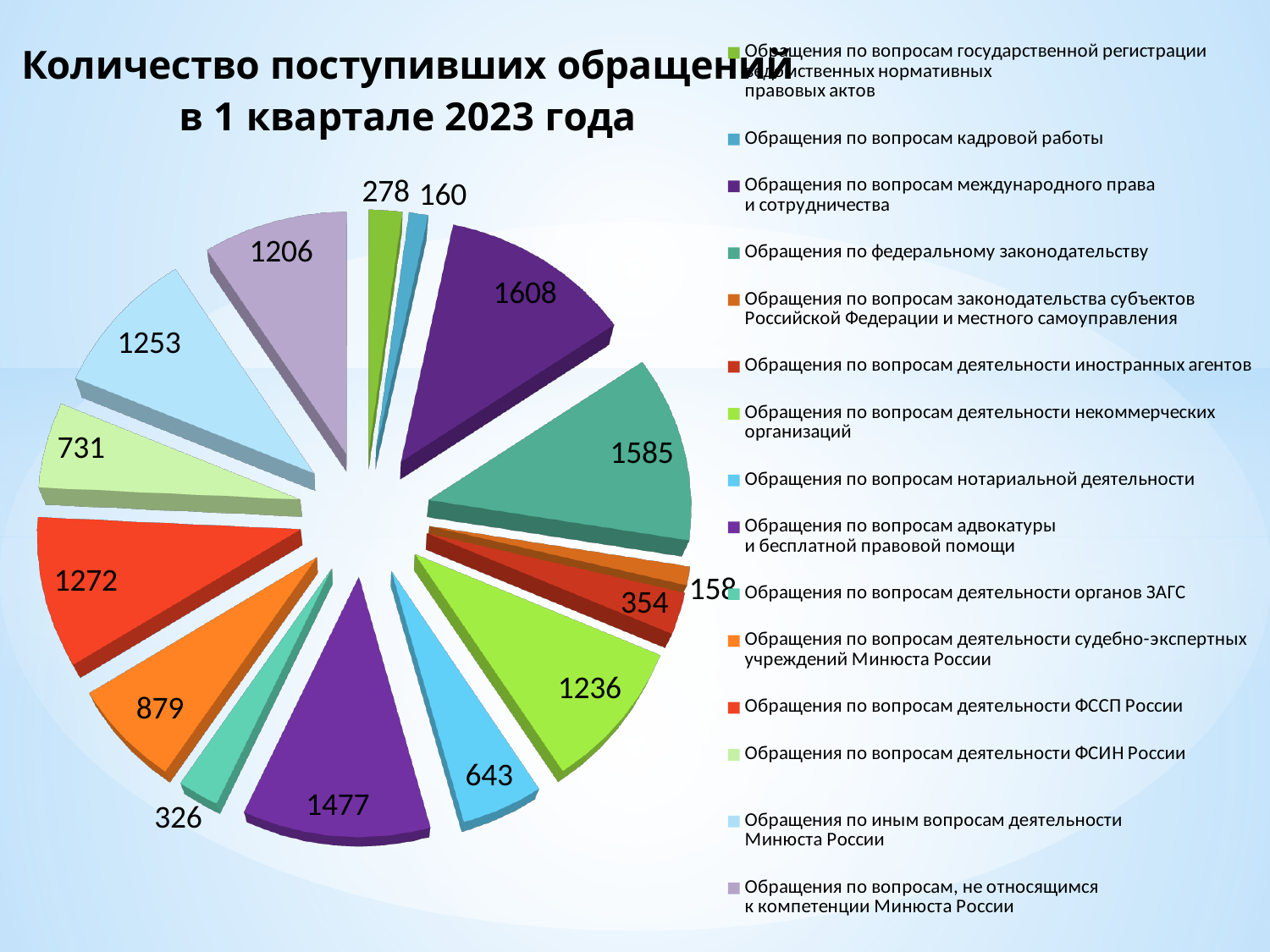
What type of chart is shown on the slide? pie chart How many entries does the legend list? 15 What is the value for 'Обращения по вопросам нотариальной деятельности'? 643 What is the difference between the values for 'Обращения по вопросам адвокатуры и бесплатной правовой помощи' and 'Обращения по вопросам деятельности ФСИН России'? 746 How many slices does the pie chart have? 15 What is the value for 'Обращения по вопросам международного права и сотрудничества'? 1608 What is the value for 'Обращения по вопросам деятельности органов ЗАГС'? 326 What is the title of the chart? Количество поступивших обращений в 1 квартале 2023 года What is the value for 'Обращения по вопросам деятельности ФССП России'? 1272 Which category has the largest value? Обращения по вопросам международного права и сотрудничества Which is larger: the value for 'Обращения по федеральному законодательству' or for 'Обращения по вопросам деятельности некоммерческих организаций'? Обращения по федеральному законодательству Which category has the smallest value? Обращения по вопросам законодательства субъектов Российской Федерации и местного самоуправления